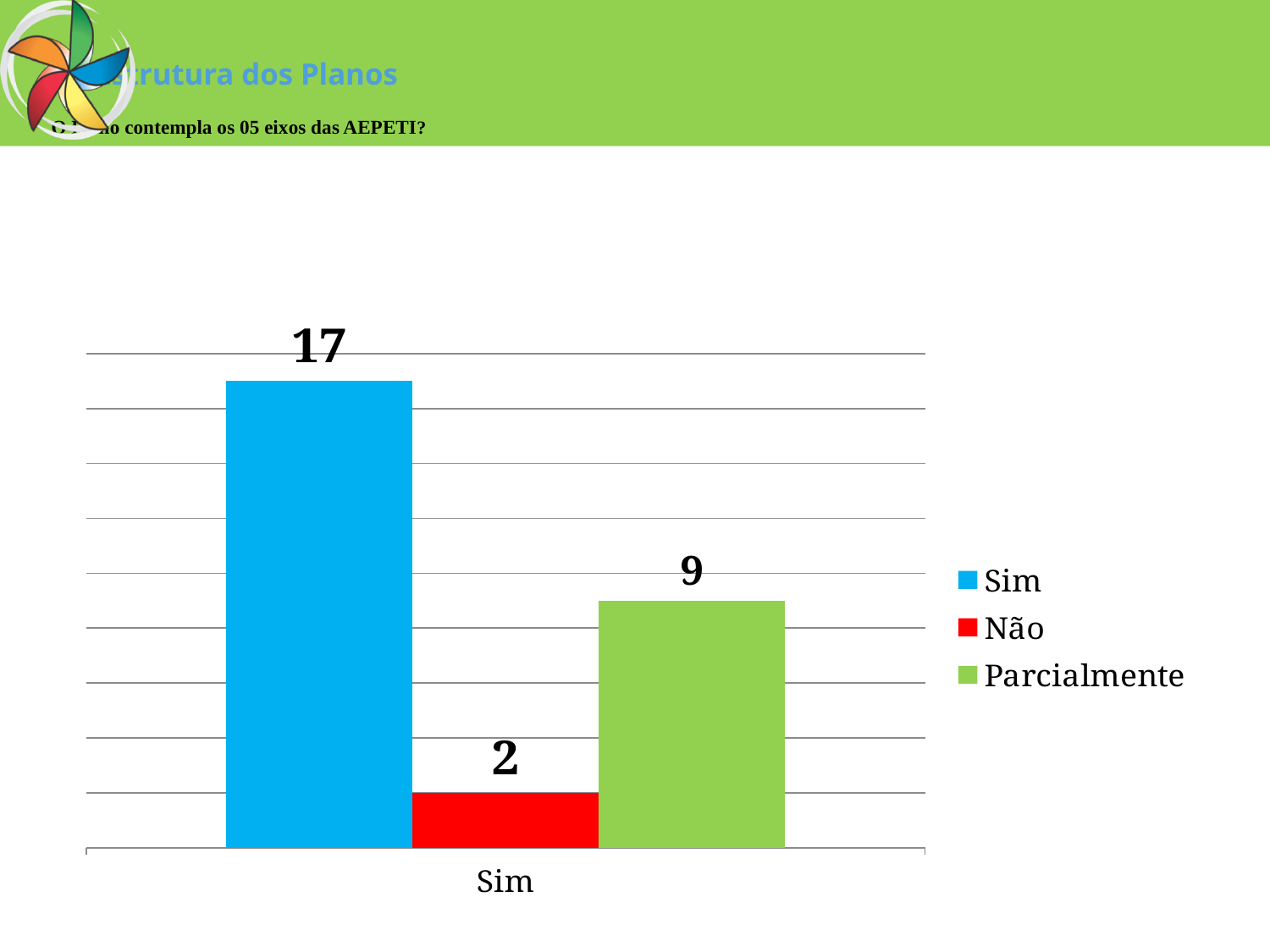
Which is larger, the value for Sim or the value for Parcialmente? Sim What is the difference between the values for Sim and Parcialmente? 8 What kind of chart is shown on the slide? bar chart What is the value for Sim? 17 What is the value for Não? 2 How many series does the legend list? 3 What is the value for Parcialmente? 9 What colour is the bar for Não? red Which series has the lowest value? Não What is the total of the three values shown? 28 Which series has the highest value? Sim What is the difference between the values for Parcialmente and Não? 7